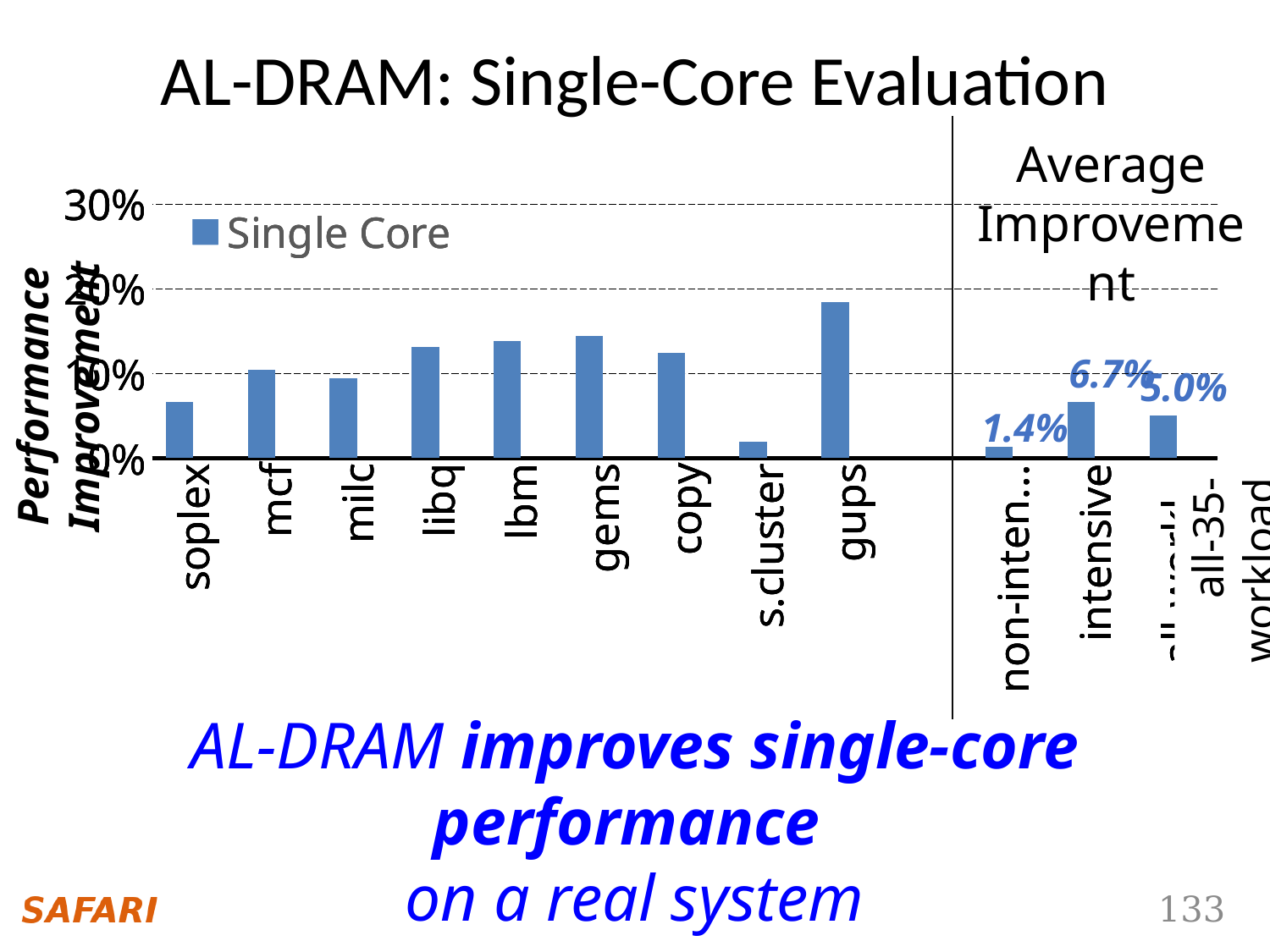
What is the difference between the intensive and non-intensive values? 5.3% What is the value for the all-35-workload category? 5.0% What is the difference between the intensive and all-35-workload values? 1.7% What kind of chart is shown on the slide? bar chart What is the value for the intensive category? 6.7% Which is larger, the value for gups or the value for gems? gups Is the value for gups greater or less than 10%? greater How many series does the legend list? 1 Is the value for soplex greater or less than 10%? less What is the value for the non-intensive category? 1.4% Which category has the highest performance improvement? gups Which is larger, the value for soplex or the value for libq? libq